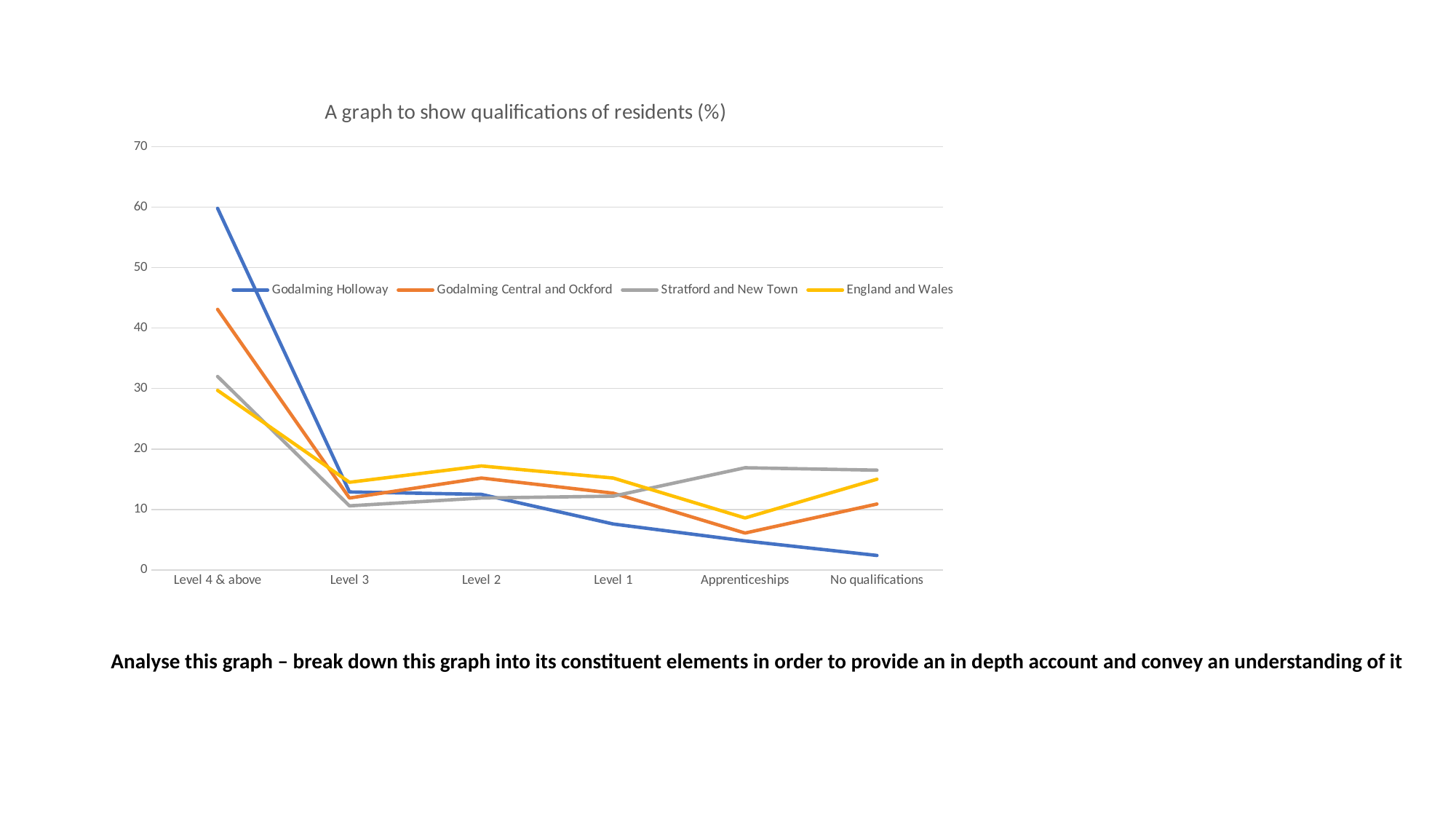
At Level 4 & above, which is larger: Godalming Central and Ockford or Stratford and New Town? Godalming Central and Ockford Which series has the highest value for Apprenticeships? Stratford and New Town What kind of chart is shown on the slide? line chart Is the value for Stratford and New Town at Apprenticeships greater or less than 10? greater How many series does the legend list? 4 How many qualification categories are shown on the x axis? 6 Is the value for Godalming Central and Ockford at Apprenticeships greater or less than 10? less Which series has the lowest value for No qualifications? Godalming Holloway Is the value for Godalming Holloway at Level 4 & above greater or less than 50? greater What is the title of the chart? A graph to show qualifications of residents (%) Which series has the highest value for Level 4 & above? Godalming Holloway Does the Godalming Holloway line rise or fall from Level 4 & above to No qualifications? fall